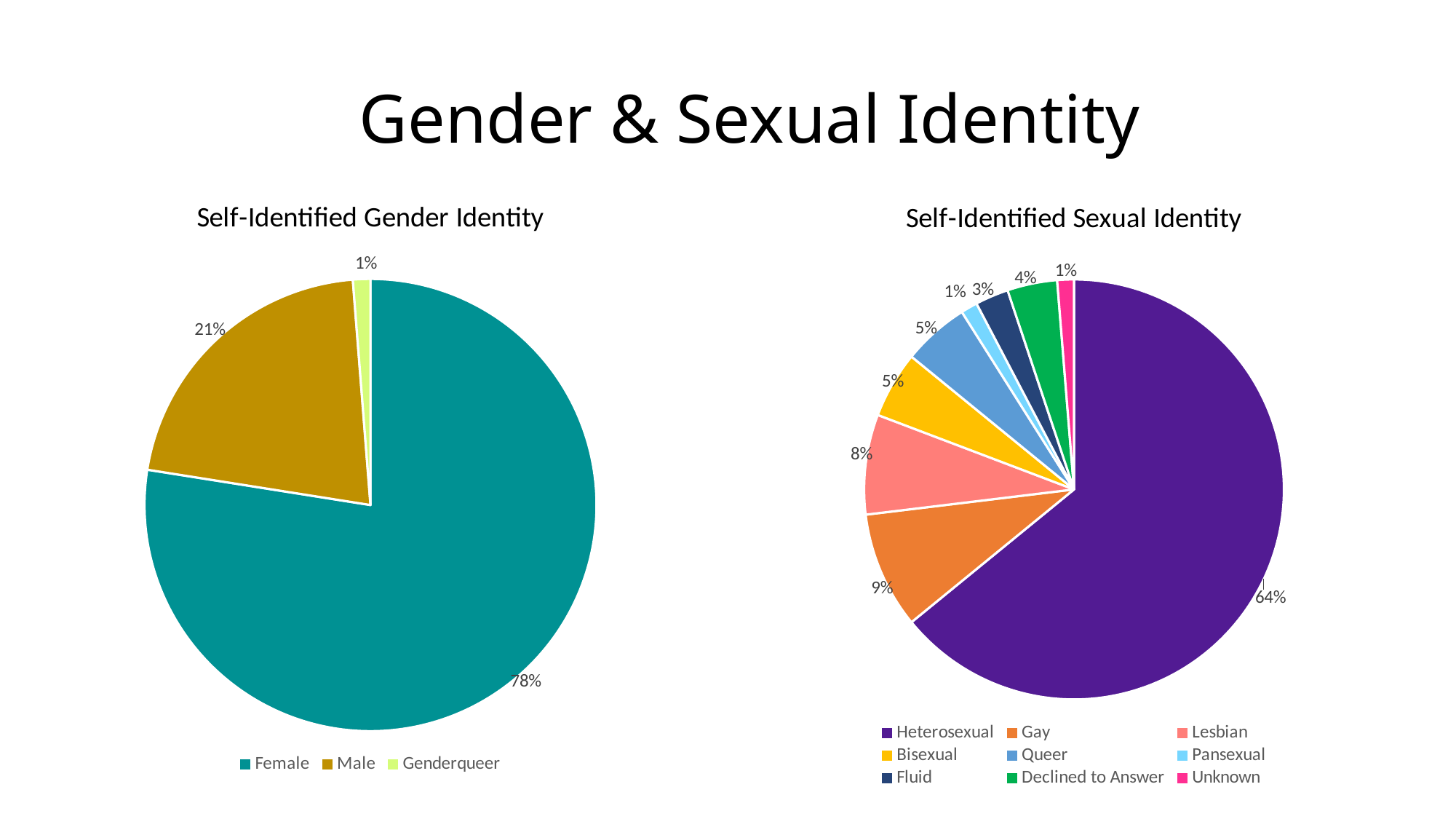
How many categories does the legend of the Self-Identified Sexual Identity chart list? 9 In the Self-Identified Gender Identity chart, what is the difference between the Female and Male shares? 57% In the Self-Identified Sexual Identity chart, what percentage identified as Lesbian? 8% In the Self-Identified Gender Identity chart, what percentage identified as Male? 21% What type of chart is the Self-Identified Sexual Identity chart? Pie chart In the Self-Identified Sexual Identity chart, what percentage identified as Heterosexual? 64% In the Self-Identified Sexual Identity chart, what percentage identified as Gay? 9% In the Self-Identified Sexual Identity chart, what percentage Declined to Answer? 4% How many categories does the Self-Identified Gender Identity chart show? 3 In the Self-Identified Gender Identity chart, what percentage identified as Genderqueer? 1% In the Self-Identified Gender Identity chart, what percentage identified as Female? 78% In the Self-Identified Sexual Identity chart, which category has the largest share? Heterosexual